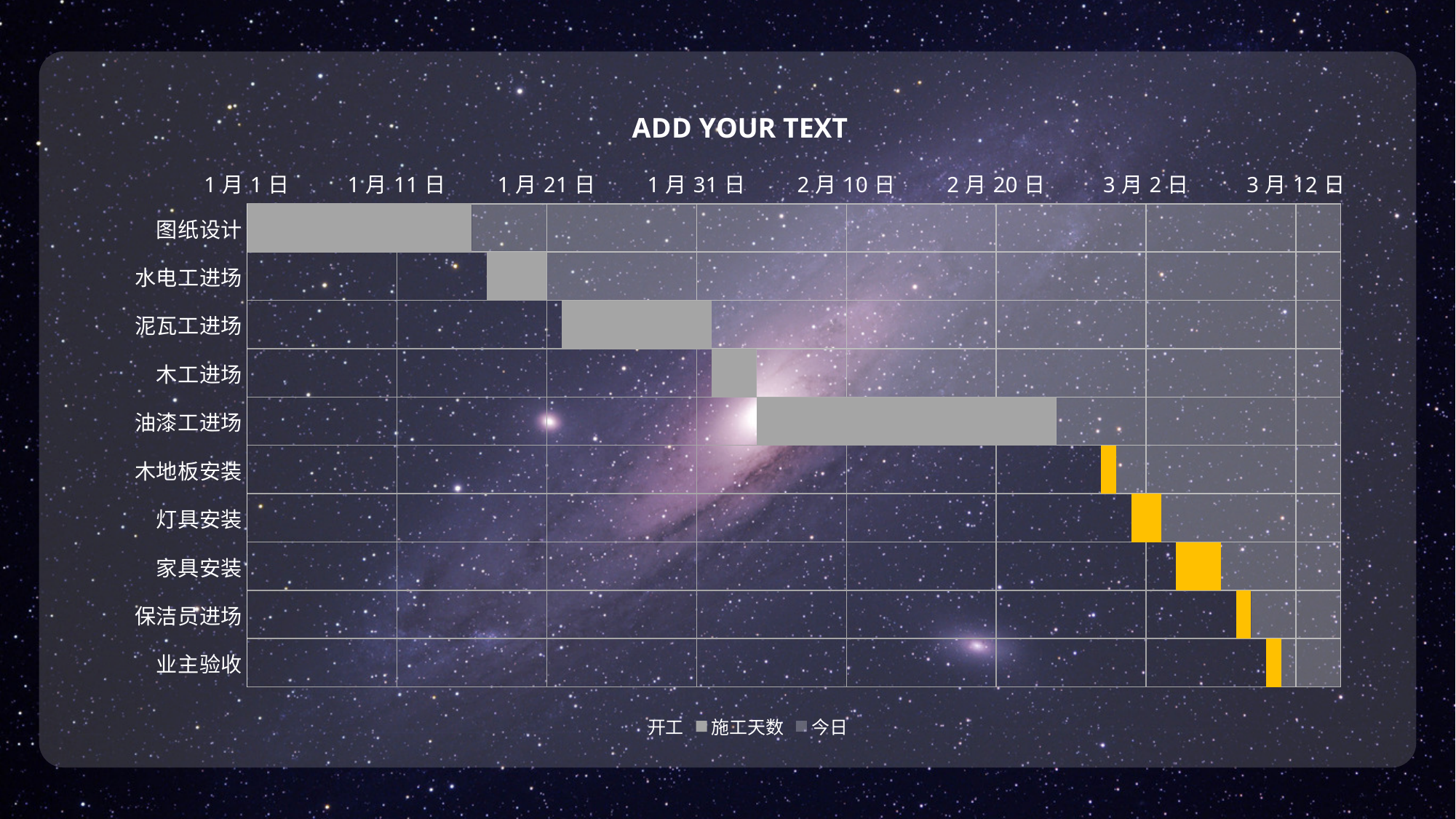
How many tasks (categories) are listed on the vertical axis of the chart? 10 Do the task start dates move earlier or later going down the list of tasks? later How many series does the chart legend list? 3 Which task's bar is longer, 图纸设计 or 水电工进场? 图纸设计 Which task's bar is longer, 泥瓦工进场 or 木工进场? 泥瓦工进场 Does the bar for 图纸设计 end before or after 1月21日? before What is the title of the chart? ADD YOUR TEXT What kind of chart is shown on the slide? bar chart What colour are the bars for the last five tasks (木地板安装 through 业主验收)? yellow Which task is the first one scheduled, starting at 1月1日? 图纸设计 Which task has the longest bar in the chart? 油漆工进场 Which task is the last one scheduled in the chart? 业主验收